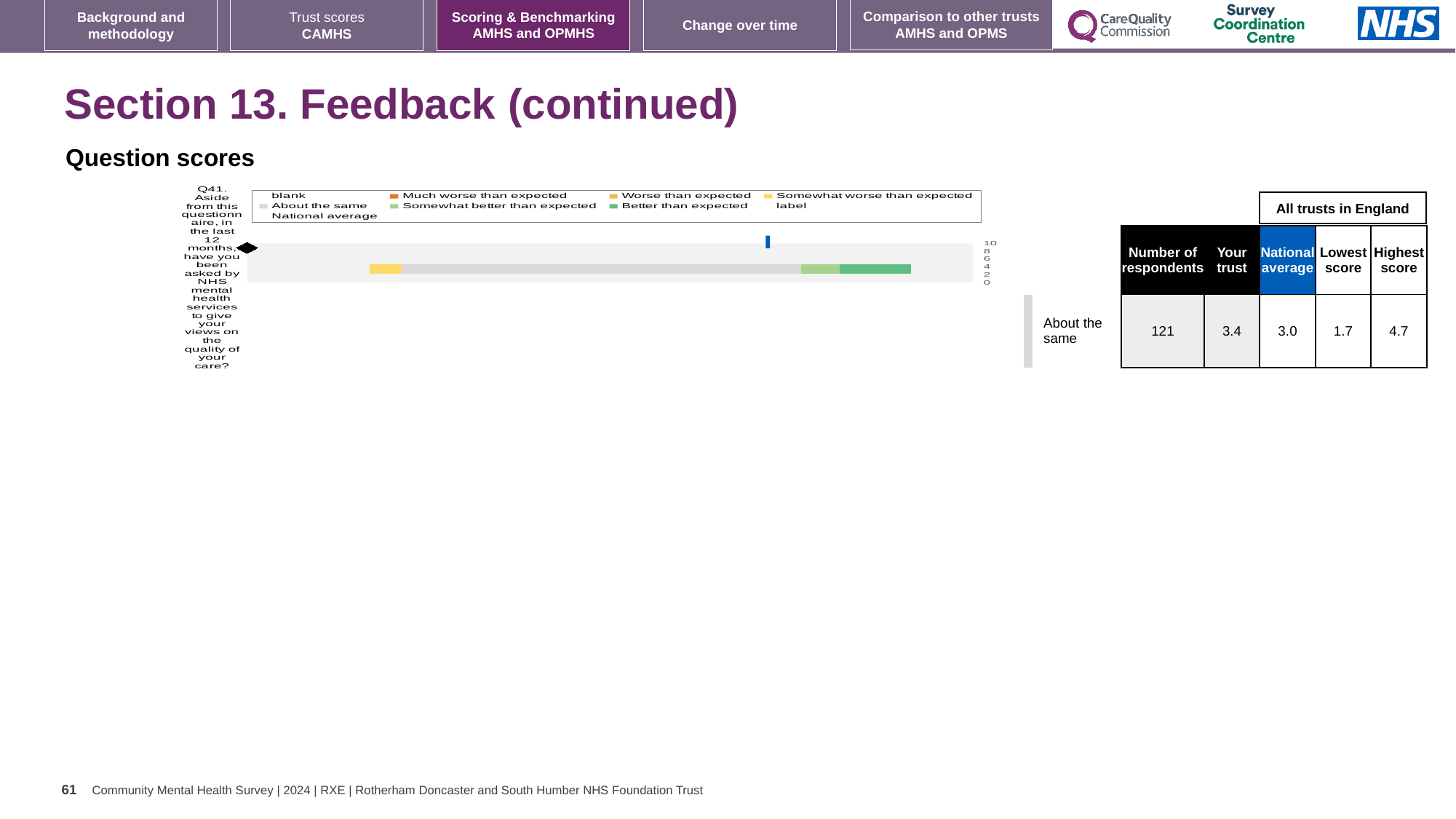
How many questions (categories) are plotted in the chart? 1 According to the table beside the chart, how many respondents answered Q41? 121 According to the table beside the chart, what is the lowest score among all trusts in England for Q41? 1.7 According to the table beside the chart, what is the 'Your trust' score for Q41? 3.4 According to the table beside the chart, what is the highest score among all trusts in England for Q41? 4.7 Which is larger for Q41: the 'Your trust' score or the national average? Your trust What benchmark category is the trust's Q41 score placed in, as labelled next to the chart? About the same What is the difference between the highest score and the lowest score for Q41 in the table beside the chart? 3.0 According to the table beside the chart, what is the national average score for Q41? 3.0 What kind of chart is shown for Q41 on the slide? bar chart What is the highest tick value shown on the chart's axis? 10 Which question number is plotted in the chart? Q41